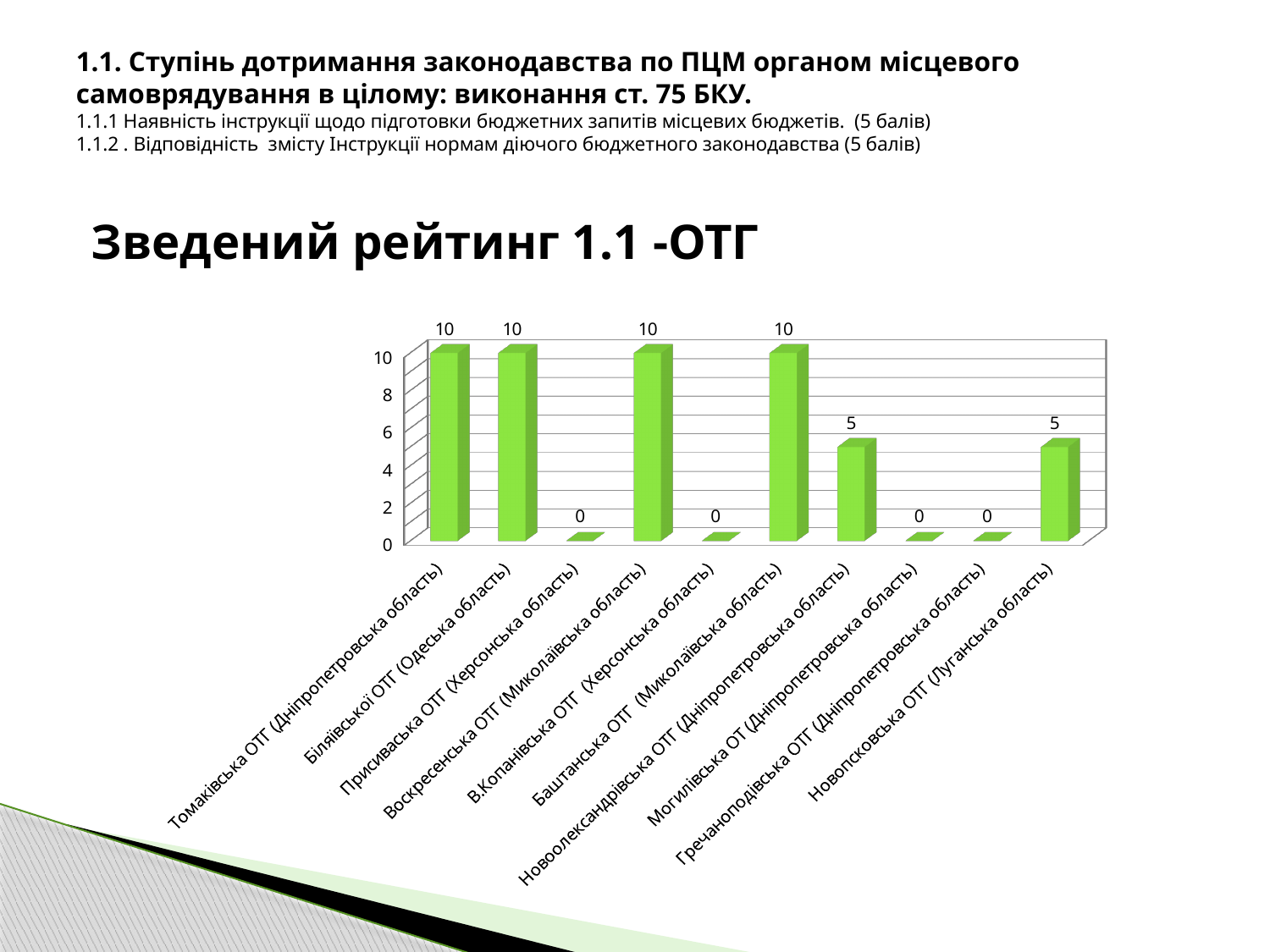
What is the highest value shown on the vertical axis? 10 What value is shown for Новоолександрівська ОТГ (Дніпропетровська область)? 5 What value is shown for Новопсковська ОТГ (Луганська область)? 5 What is the difference between the values for Воскресенська ОТГ (Миколаївська область) and Новопсковська ОТГ (Луганська область)? 5 How many categories have a value of 0? 4 What value is shown for Присиваська ОТГ (Херсонська область)? 0 What value is shown for Баштанська ОТГ (Миколаївська область)? 10 How many categories are plotted on the x axis of the chart? 10 Which is larger, the value for Біляївської ОТГ (Одеська область) or the value for Могилівська ОТ (Дніпропетровська область)? Біляївської ОТГ (Одеська область) What kind of chart is shown on the slide? Bar chart What value is shown for Томаківська ОТГ (Дніпропетровська область)? 10 What is the title of the chart? Зведений рейтинг 1.1 -ОТГ